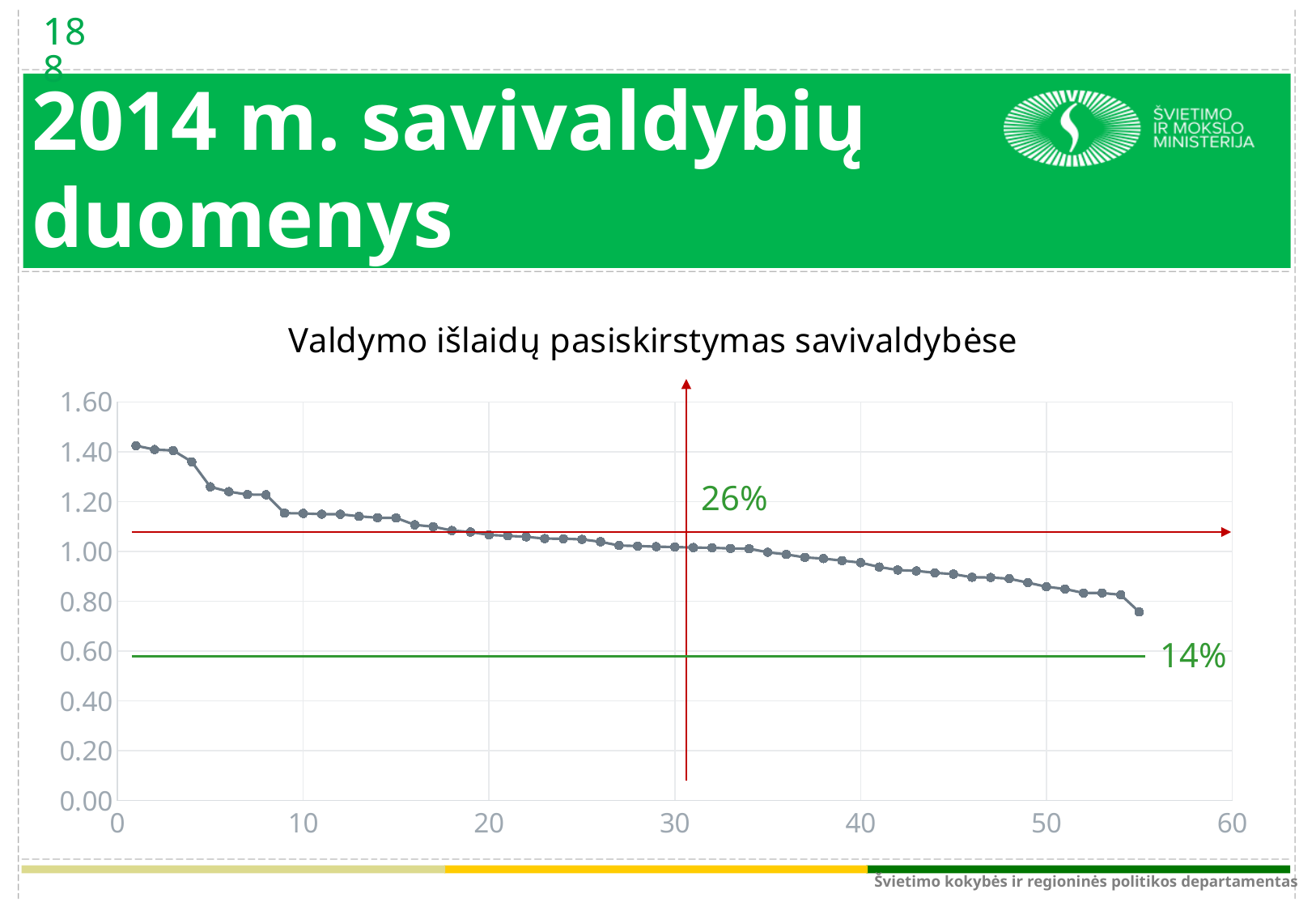
What percentage label is written above the horizontal red line? 26% Which is larger, the value at x = 5 or the value at x = 40? x = 5 What is the highest tick value shown on the y axis? 1.60 What is the highest tick value shown on the x axis? 60 What kind of chart is shown on the slide? line chart At which x position is the highest value plotted? 1 Do the plotted values rise or fall as the x axis increases? fall What is the title of the chart? Valdymo išlaidų pasiskirstymas savivaldybėse Is the value of the last point (around x = 55) greater or less than 0.80? less Is the value at x = 50 greater or less than 1.00? less Is the value at x = 10 greater or less than 1.00? greater